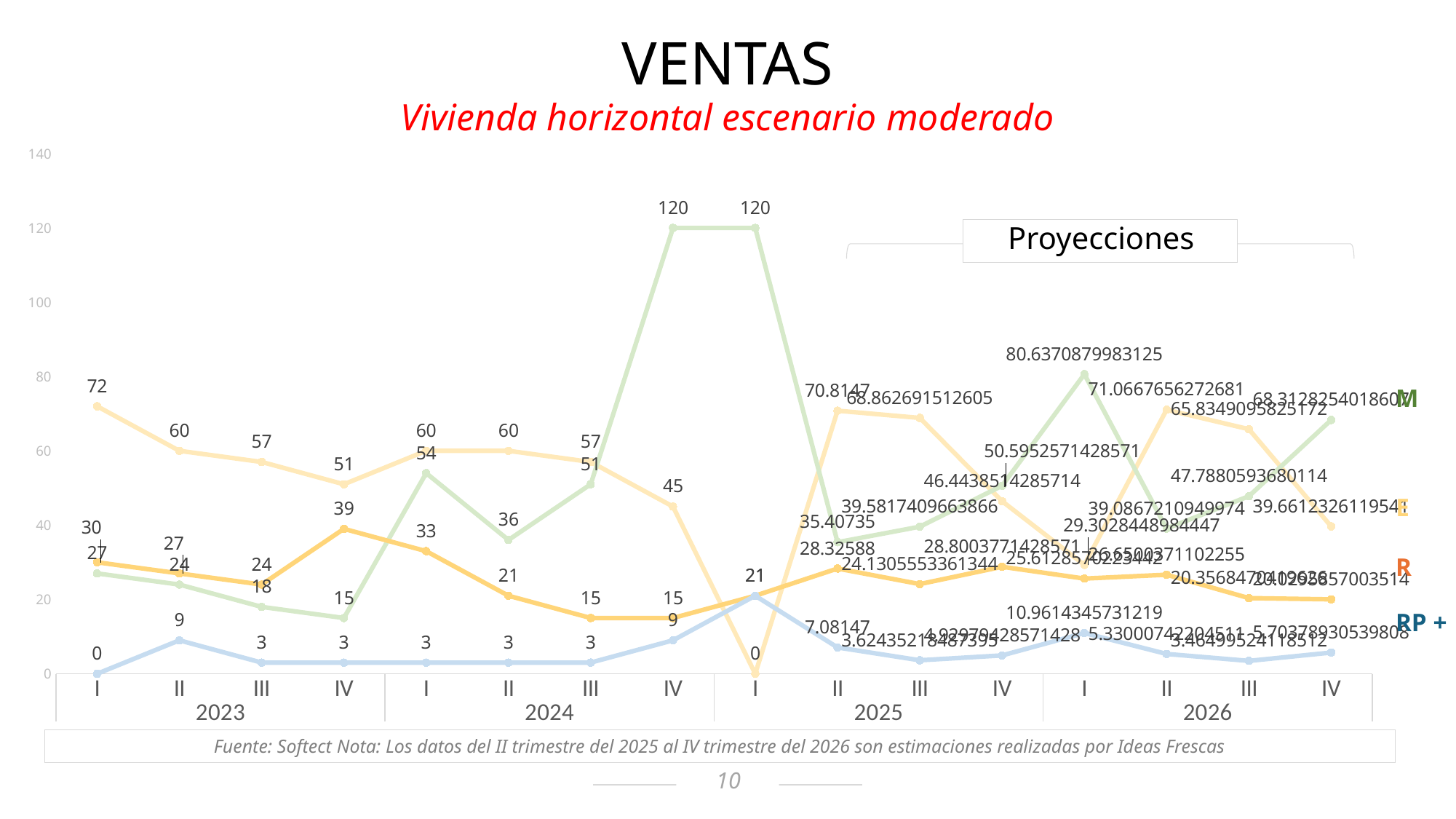
Is the value of the M series in quarter I of 2026 greater or less than 60? greater How many series are labelled on the chart? 4 How many quarterly data points does each series have on the x axis? 16 What is the highest value reached by the M series? 120 What is the value of the RP + series in quarter II of 2023? 9 What is the lowest value of the RP + series, reached in quarter I of 2023? 0 What is the value of the R series in quarter IV of 2023? 39 What is the difference between the M series values in quarter IV of 2024 and quarter III of 2024? 69 What is the value of the E series in quarter I of 2023? 72 What is the value of the M series in quarter IV of 2024? 120 What kind of chart is shown on the slide? line chart In quarter I of 2024, which series is larger, M or R? M